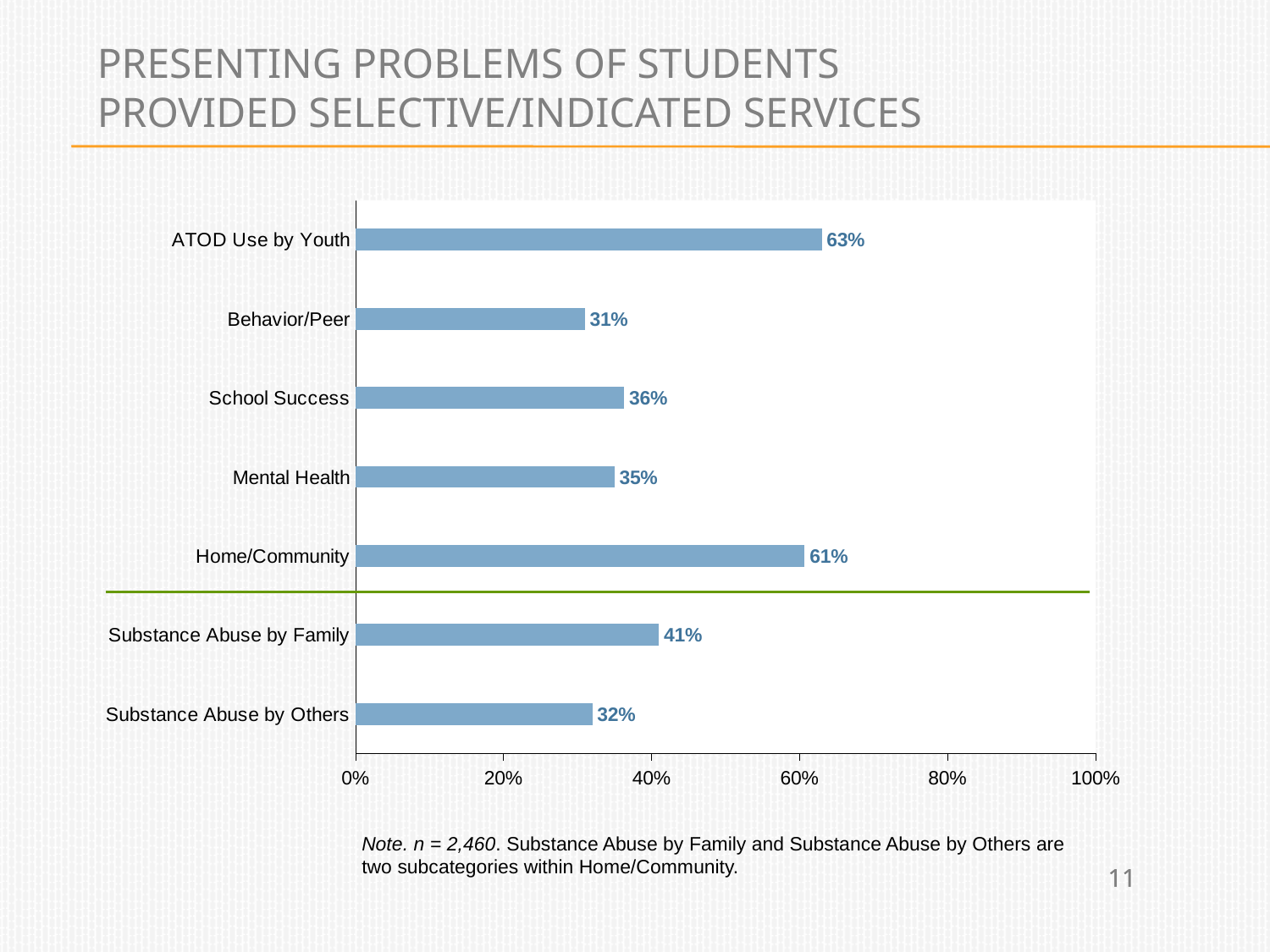
What is the value for Mental Health? 35% According to the note, what is the sample size n? 2,460 What is the value for Substance Abuse by Family? 41% Is the value for Home/Community greater or less than 40%? greater How many categories are shown in the chart? 7 What is the value for ATOD Use by Youth? 63% Which category has the highest value? ATOD Use by Youth What is the difference between the values for Home/Community and Substance Abuse by Family? 20% Which category has the lowest value? Behavior/Peer What is the difference between the values for ATOD Use by Youth and Behavior/Peer? 32% What kind of chart is shown on the slide? Bar chart Which is larger, the value for Substance Abuse by Family or the value for Substance Abuse by Others? Substance Abuse by Family